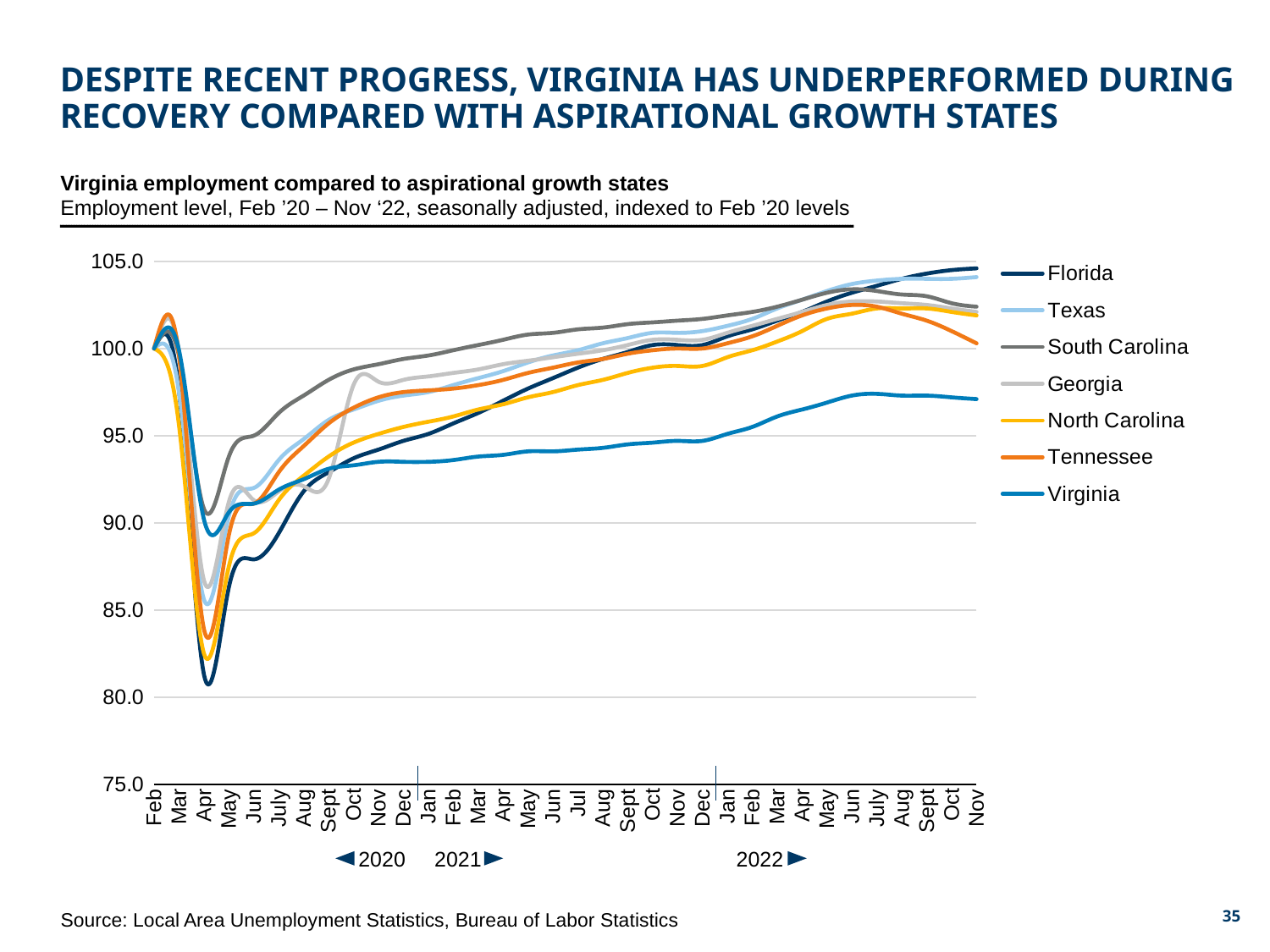
How many series does the legend list? 7 Is the value for Florida in April 2020 greater or less than 85.0? less Which is larger in November 2022, the value for Florida or the value for Virginia? Florida Does the Tennessee line rise or fall from July 2022 to November 2022? fall What is the title of the chart? Virginia employment compared to aspirational growth states Is the value for Virginia in November 2022 greater or less than 100.0? less Does the Virginia line rise or fall from January 2021 to November 2022? rise Is the value for Florida in November 2022 greater or less than 100.0? greater What kind of chart is shown on the slide? line chart Which state has the lowest employment index in November 2022? Virginia Which state's employment index fell lowest in April 2020? Florida